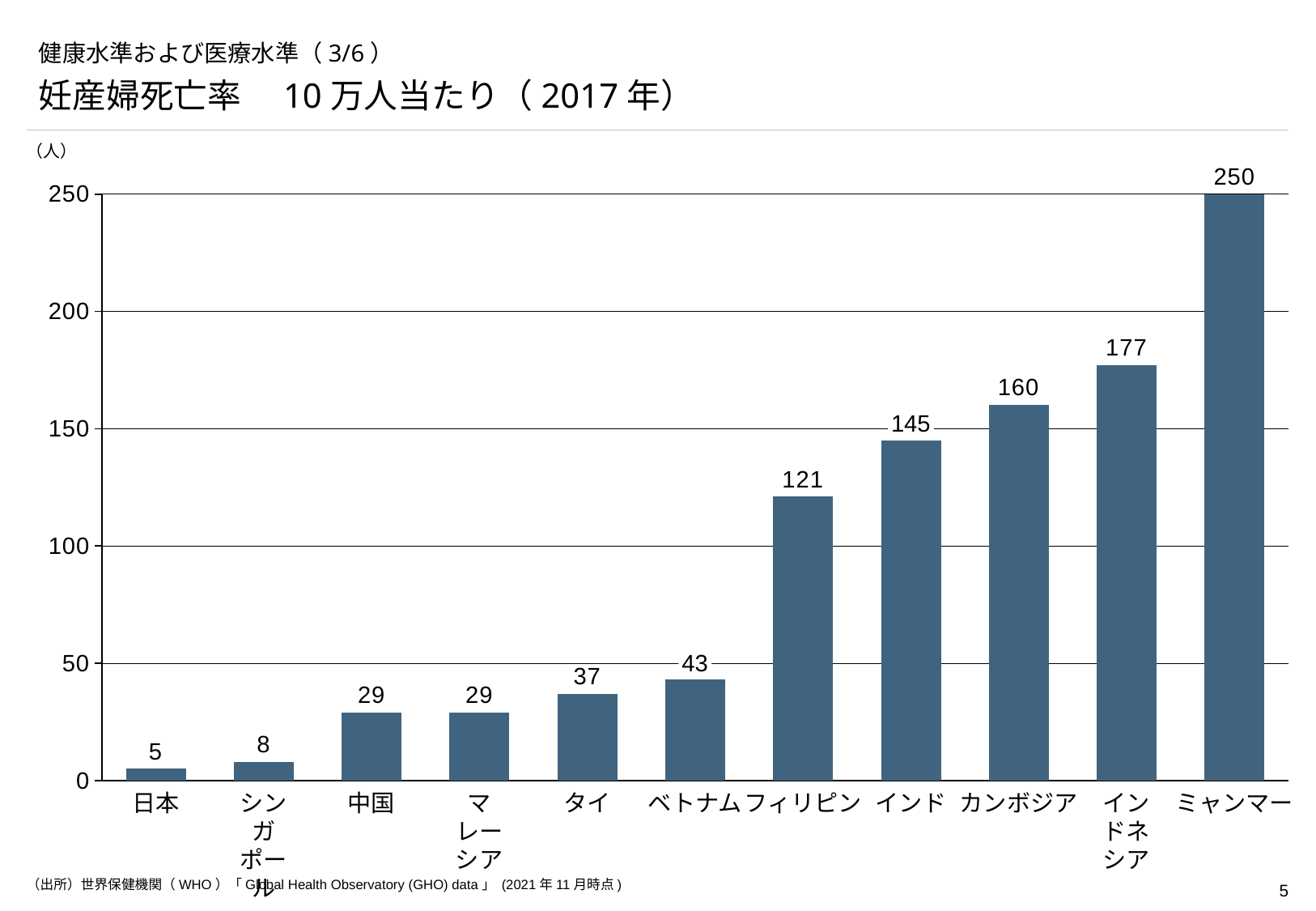
Do the values rise or fall from left to right along the x axis? rise What is the difference between the values for ミャンマー and インドネシア? 73 Which country has the lowest maternal mortality rate on the chart? 日本 Is the value for インドネシア greater or less than 150? greater Which has a higher value, フィリピン or ベトナム? フィリピン What value is shown for カンボジア (Cambodia)? 160 Which country has the highest maternal mortality rate on the chart? ミャンマー What kind of chart is shown on the slide? bar chart How many countries are shown on the chart? 11 What is the difference between the values for ベトナム and タイ? 6 What value is shown for インド (India)? 145 What is the maternal mortality rate shown for 日本 (Japan)? 5